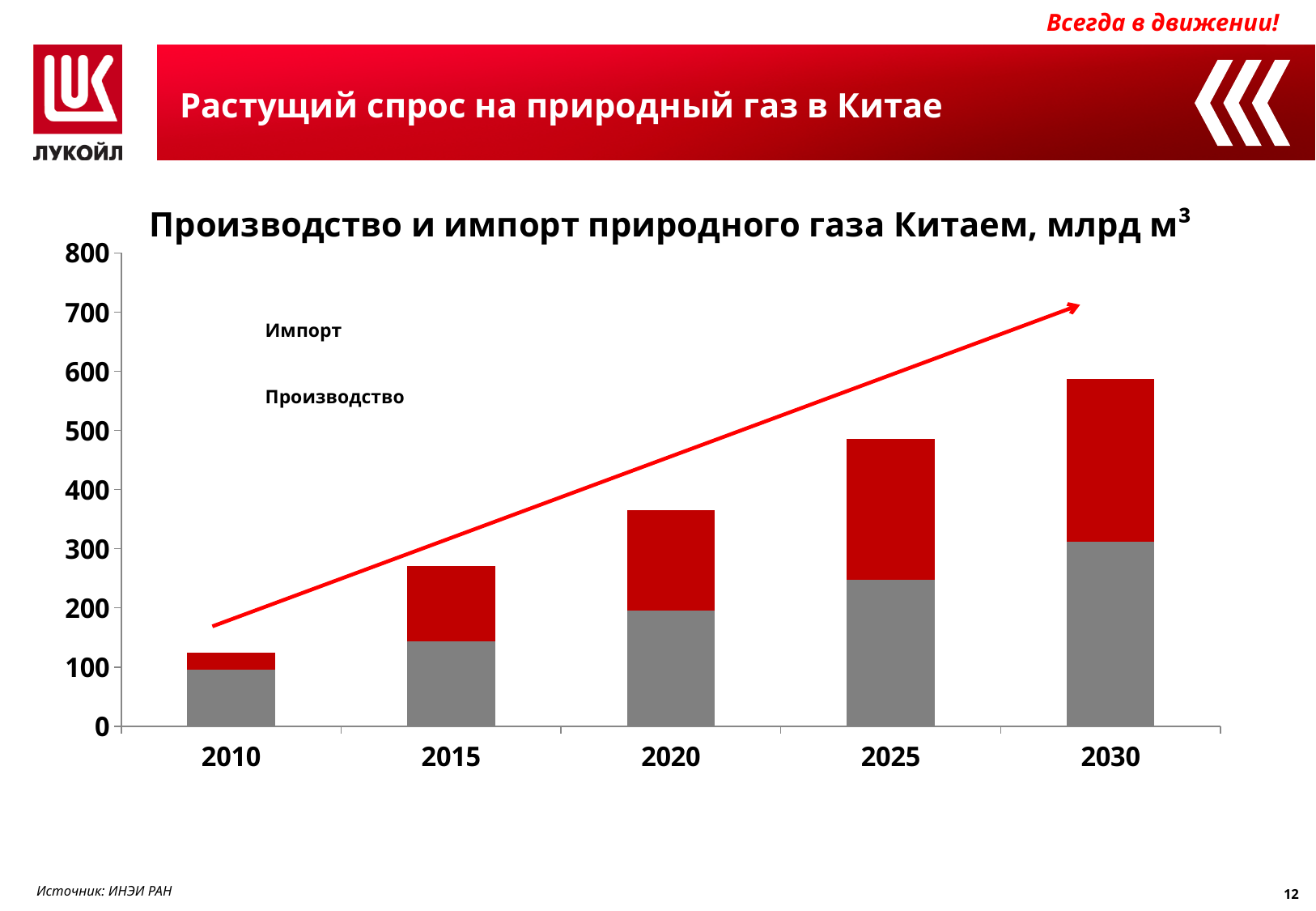
How many series does the chart's legend list? 2 Is the total bar for 2010 greater or less than 200? less Which year has the shortest stacked bar? 2010 Is the total bar for 2020 greater or less than 300? greater Which year has the tallest stacked bar? 2030 Do the total bar heights rise or fall from 2010 to 2030? rise Is the total bar for 2030 greater or less than 500? greater Which year has the larger total bar, 2015 or 2025? 2025 What kind of chart is shown on the slide? bar chart How many years are shown on the x axis of the chart? 5 What are the two series named in the chart's legend? Импорт and Производство